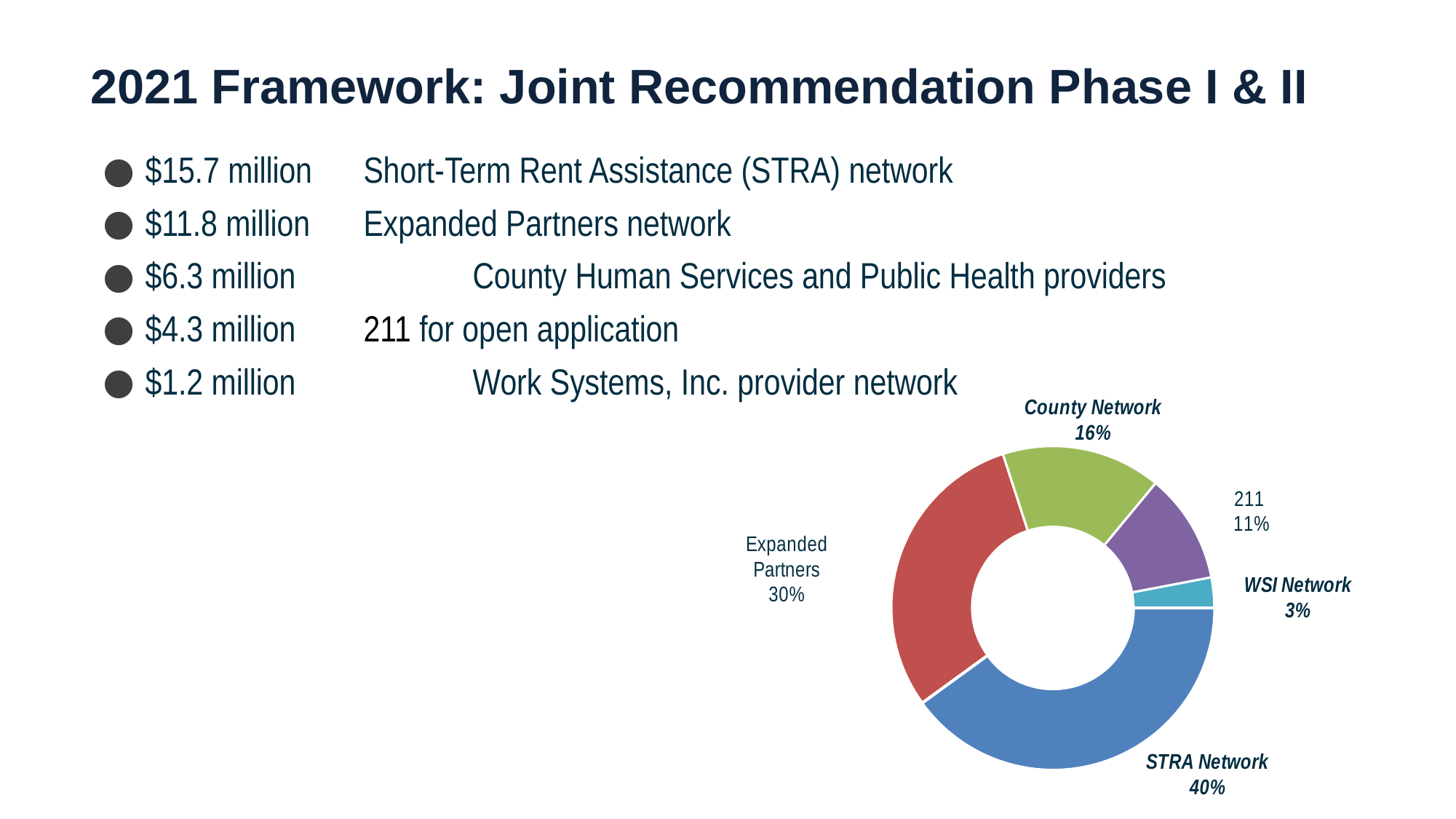
What share of the pie does the County Network slice represent? 16% Which slice of the pie chart is the smallest? WSI Network What share of the pie does the WSI Network slice represent? 3% What share of the pie does the STRA Network slice represent? 40% How many slices does the pie chart have? 5 What colour is the STRA Network slice in the pie chart? Blue What is the difference in percentage points between the STRA Network and Expanded Partners slices? 10 percentage points Which slice of the pie chart is the largest? STRA Network Which slice is larger, County Network or 211? County Network What kind of chart is shown on the slide? Pie chart (doughnut)